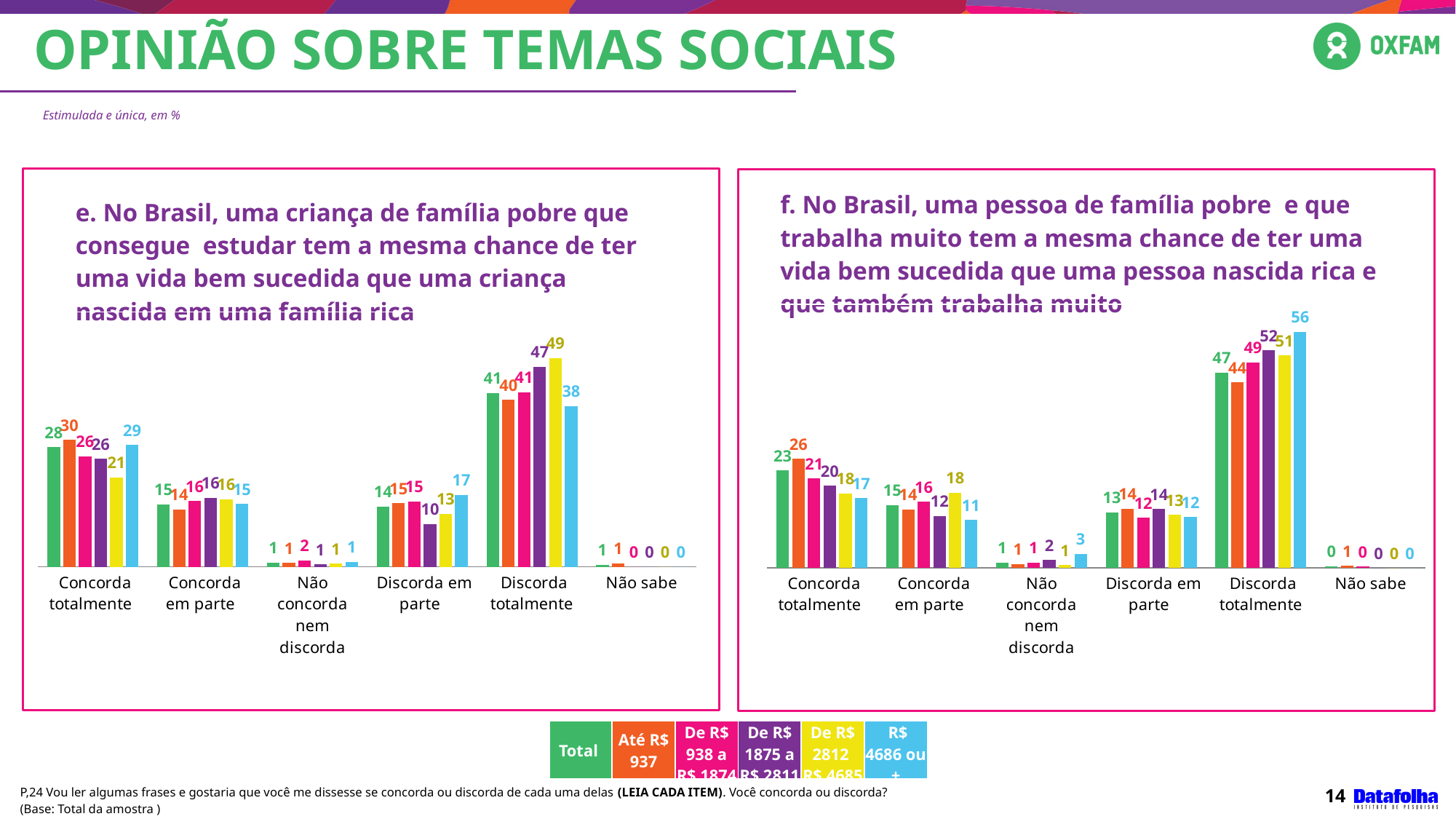
In the left chart (statement e.), what is the Total value for "Discorda totalmente"? 41 What type of chart is the right chart (statement f.)? Bar chart In the right chart (statement f.), what is the Total value for "Não sabe"? 0 In the right chart (statement f.), which income group has the lowest value for "Concorda totalmente"? R$ 4686 ou + In the left chart (statement e.), which income group has the highest value for "Discorda totalmente"? De R$ 2812 a R$ 4685 In the left chart (statement e.), what is the difference between the "R$ 4686 ou +" value and the "De R$ 1875 a R$ 2811" value for "Discorda em parte"? 7 In the left chart (statement e.), what is the difference between the "Até R$ 937" value and the "De R$ 2812 a R$ 4685" value for "Concorda totalmente"? 9 How many series does the legend at the bottom of the slide list? 6 In the right chart (statement f.), what is the value for "R$ 4686 ou +" in the "Discorda totalmente" category? 56 Which colour represents the "Total" series in the legend? Green How many response categories are shown on the x axis of the left chart (statement e.)? 6 In the right chart (statement f.), which is larger for "Concorda em parte": the "De R$ 2812 a R$ 4685" value or the "R$ 4686 ou +" value? De R$ 2812 a R$ 4685